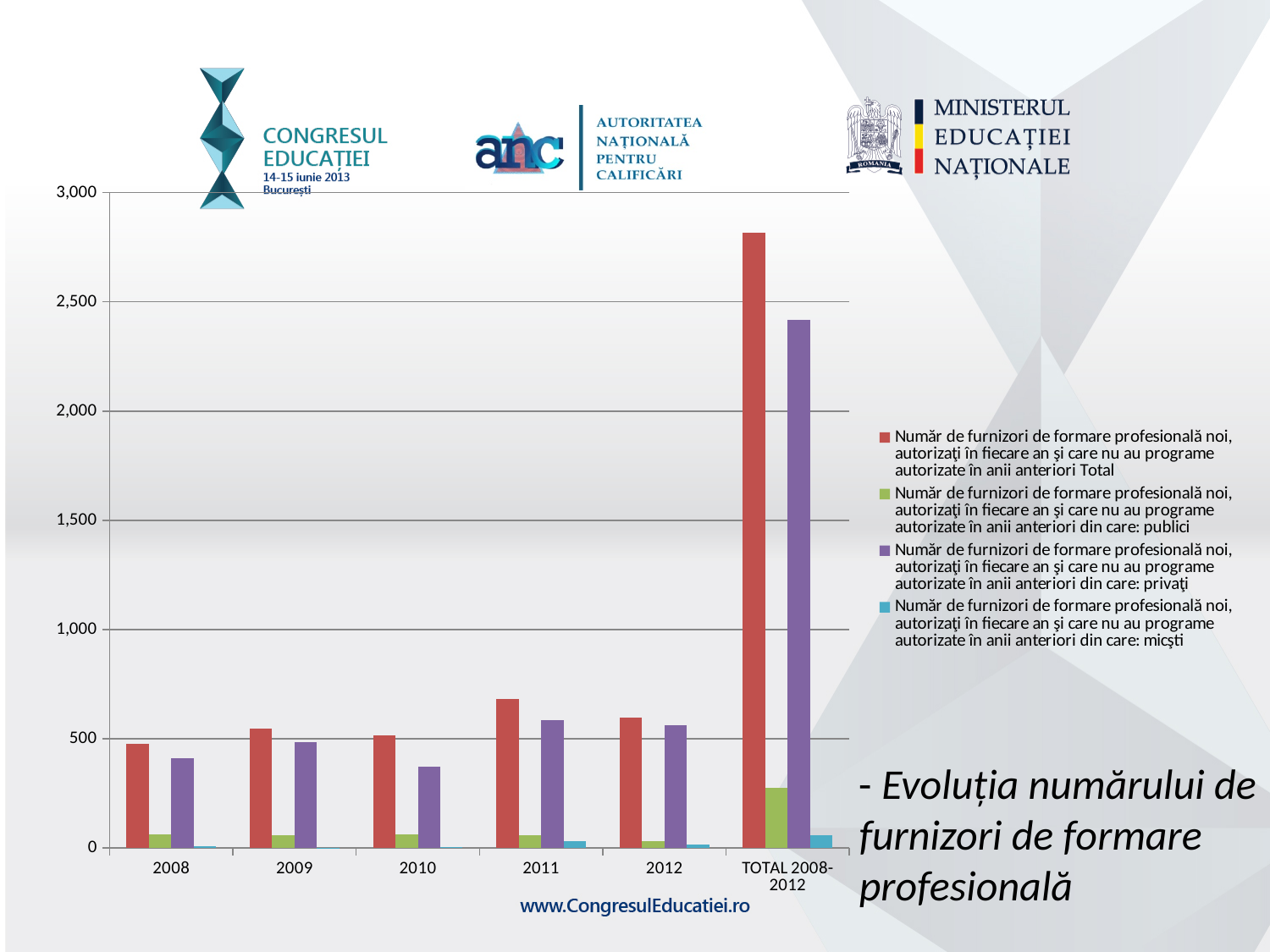
Which series has the lowest value in every category of the chart? din care: micşti How many categories are shown along the x axis of the chart? 6 Which is larger for the 'din care: privaţi' series (purple): the value for 2009 or the value for 2010? 2009 What kind of chart is shown on the slide? bar chart Is the value of the 'din care: privaţi' series (purple) for 2010 greater or less than 500? less Is the value of the 'Total' series (red) for 2011 greater or less than 500? greater Is the value of the 'din care: publici' series (green) for TOTAL 2008-2012 greater or less than 500? less What colour are the bars for the 'din care: privaţi' series? purple Among the individual years 2008 to 2012, which year has the highest value for the 'Total' series (red)? 2011 How many series does the chart's legend list? 4